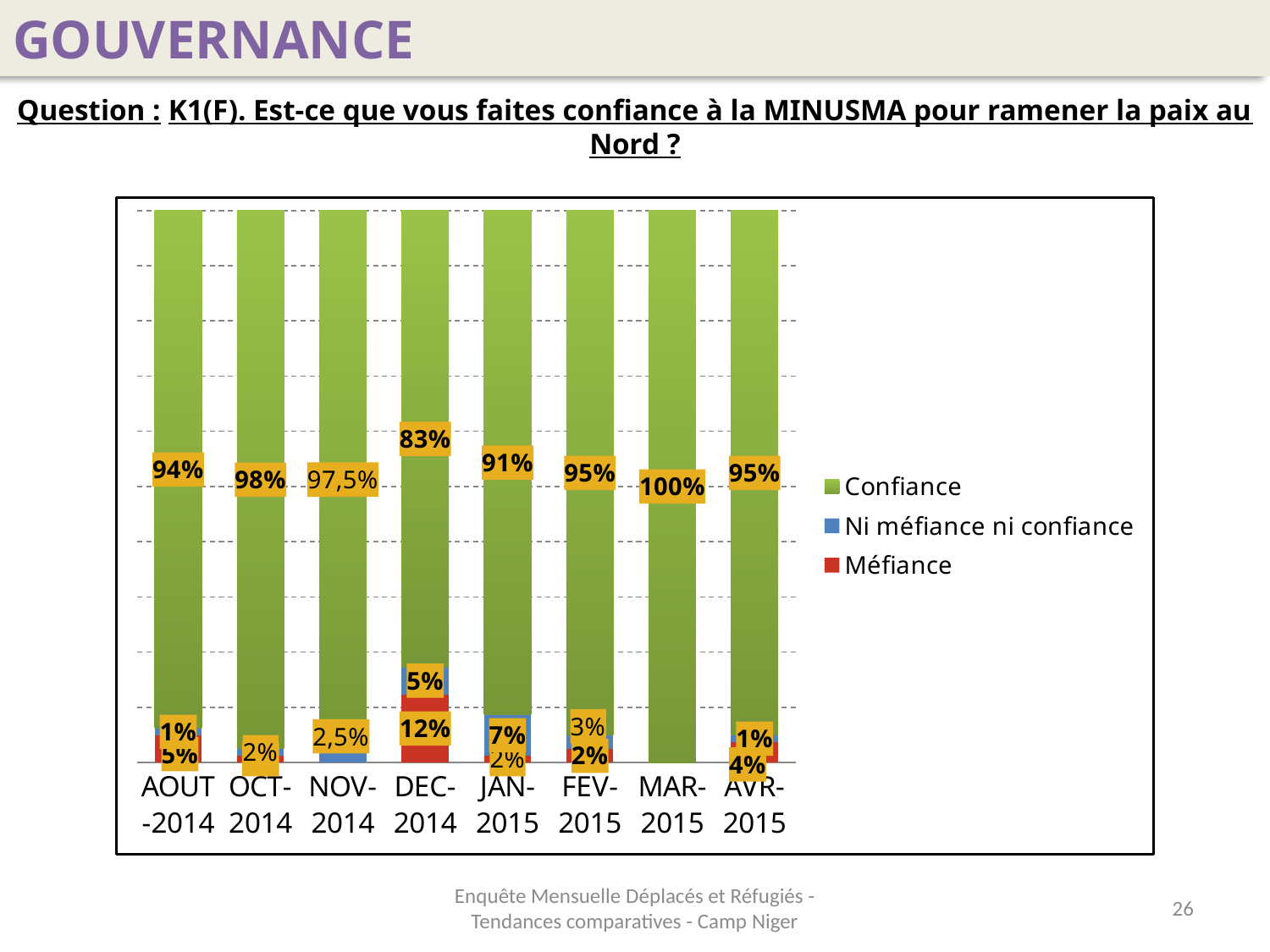
Which month has the highest Confiance value? MAR-2015 Which series is shown in green in the legend? Confiance Which has a higher Confiance value, AOUT-2014 or FEV-2015? FEV-2015 What is the difference between the Confiance values for OCT-2014 and DEC-2014? 15% How many months are shown on the x axis? 8 How many series does the legend list? 3 What kind of chart is shown on the slide? Stacked bar chart What is the Confiance value for JAN-2015? 91% Which month has the lowest Confiance value? DEC-2014 What is the Confiance value for NOV-2014? 97,5% What is the Méfiance value for DEC-2014? 12% What is the Confiance value for DEC-2014? 83%